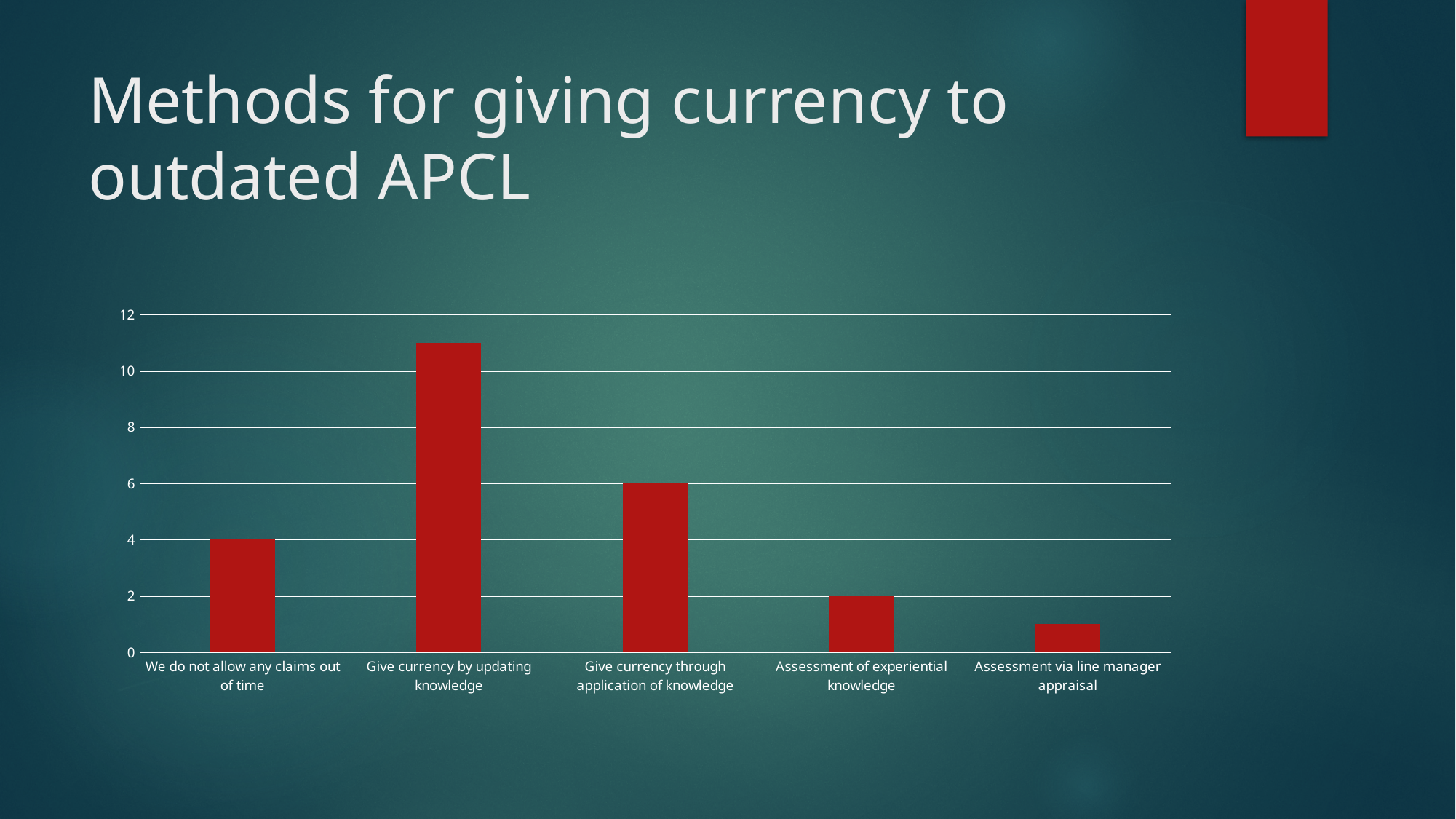
What is the value for "Assessment of experiential knowledge"? 2 What is the value for "We do not allow any claims out of time"? 4 What colour are the bars in the chart? red What is the value for "Give currency through application of knowledge"? 6 How many categories are shown on the x axis of the chart? 5 Is the value for "Assessment via line manager appraisal" greater or less than 2? less Is the value for "Give currency by updating knowledge" greater or less than 10? greater Which is larger: the value for "Give currency through application of knowledge" or the value for "Assessment of experiential knowledge"? Give currency through application of knowledge What kind of chart is shown on the slide? bar chart What is the difference between the values for "Give currency through application of knowledge" and "We do not allow any claims out of time"? 2 Which category has the highest bar? Give currency by updating knowledge Which category has the lowest bar? Assessment via line manager appraisal